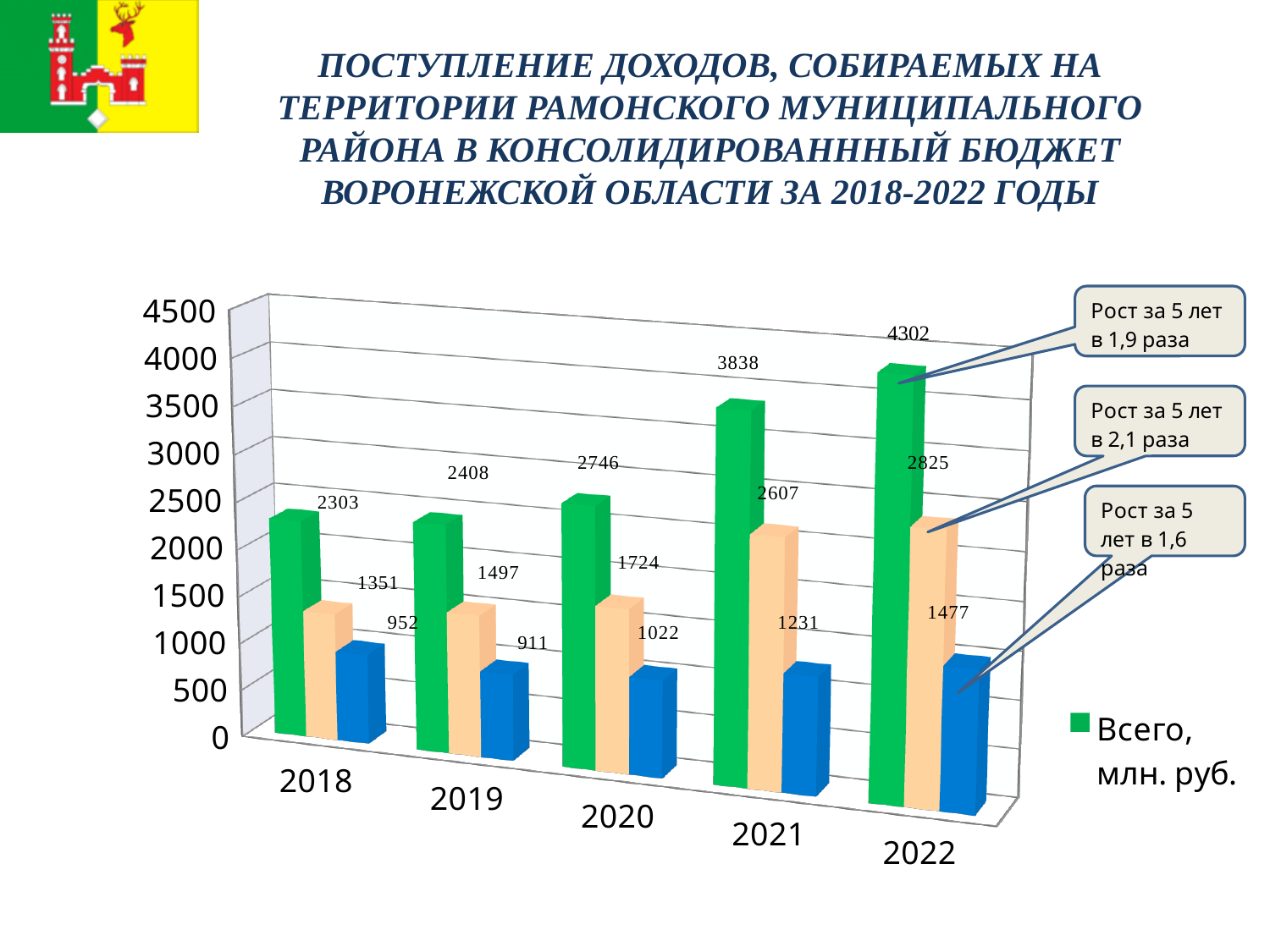
In which year is the blue bar the lowest? 2019 What kind of chart is shown on the slide? bar chart What is the value of the green 'Всего, млн. руб.' bar for 2018? 2303 Which year has the larger blue bar value, 2019 or 2020? 2020 What is the value labelled on the peach-coloured bar for 2021? 2607 Is the 'Всего, млн. руб.' value for 2021 greater or less than 3500? greater What is the difference between the 'Всего, млн. руб.' values for 2022 and 2018? 1999 What is the value labelled on the blue bar for 2019? 911 How many years are shown on the x axis of the chart? 5 What is the value of the 'Всего, млн. руб.' series for 2022? 4302 In which year is the 'Всего, млн. руб.' value the highest? 2022 Do the 'Всего, млн. руб.' values rise or fall from 2018 to 2022? rise